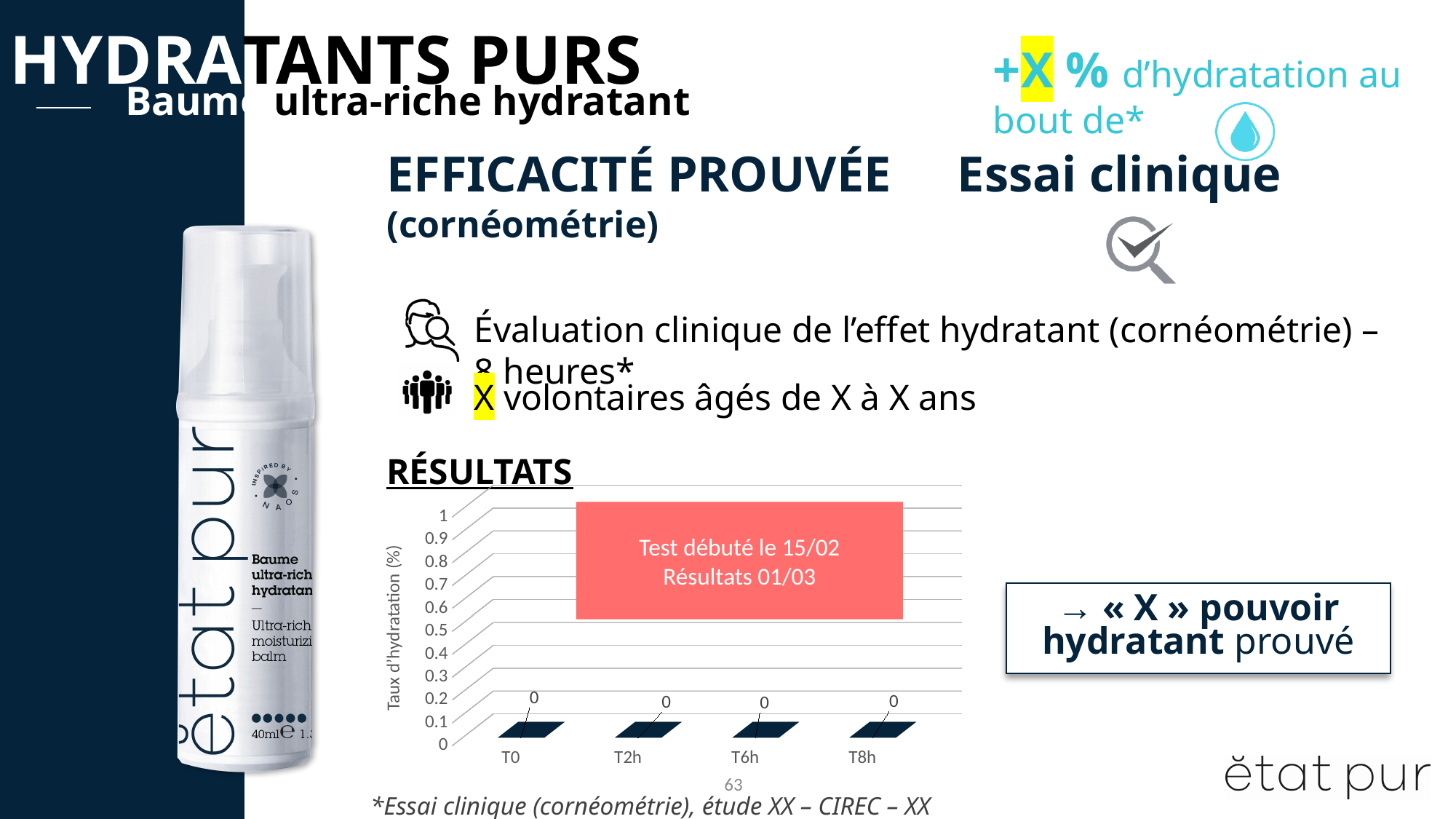
What is the value plotted for T2h? 0 What is the value plotted for T0? 0 Do the plotted values rise, fall or stay the same from T0 to T8h? stay the same How many categories are shown on the x axis of the chart? 4 What is the label of the vertical axis of the chart? Taux d'hydratation (%) What is the value plotted for T6h? 0 What is the value plotted for T8h? 0 What is the difference between the values for T8h and T0? 0 Is the value for T6h greater or less than 0.5? less What is the label of the first category on the x axis? T0 What is the highest value shown on the vertical axis of the chart? 1 What kind of chart is shown under RÉSULTATS? bar chart